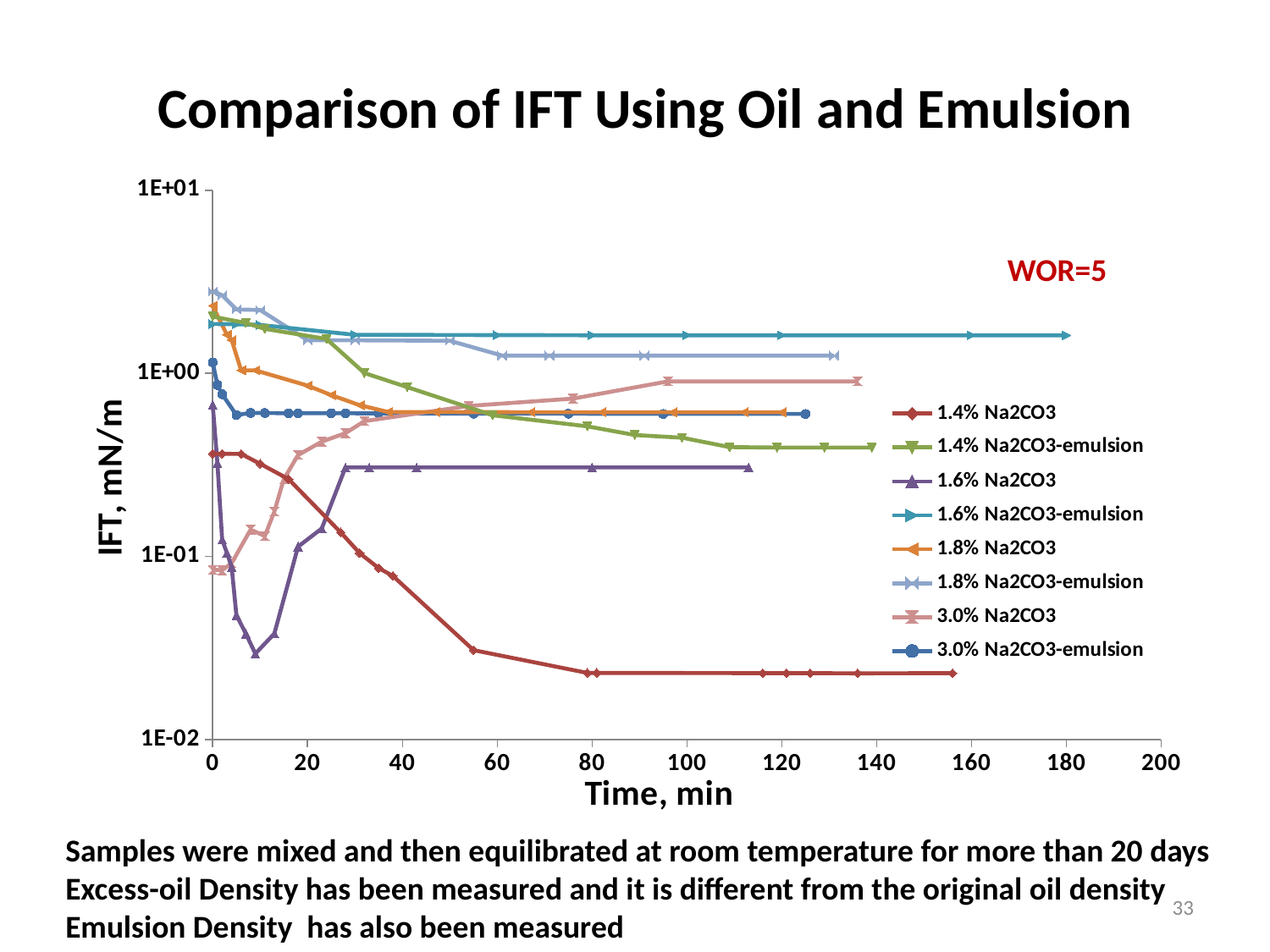
Is the value for 1.4% Na2CO3 at 80 min greater or less than 1E-01? less Is the value for 1.4% Na2CO3-emulsion at 140 min greater or less than 1E+00? less At 100 min, which is larger: the IFT for 1.6% Na2CO3-emulsion or for 1.4% Na2CO3? 1.6% Na2CO3-emulsion Does the IFT for 3.0% Na2CO3 rise or fall as time increases? rise Which series has the lowest IFT at 100 min? 1.4% Na2CO3 What is the label of the y axis? IFT, mN/m What is the title of the chart? Comparison of IFT Using Oil and Emulsion What kind of chart is shown on the slide? line chart How many series does the legend list? 8 Is the value for 1.6% Na2CO3 at 10 min greater or less than 1E-01? less Does the IFT for 1.4% Na2CO3 rise or fall as time increases? fall